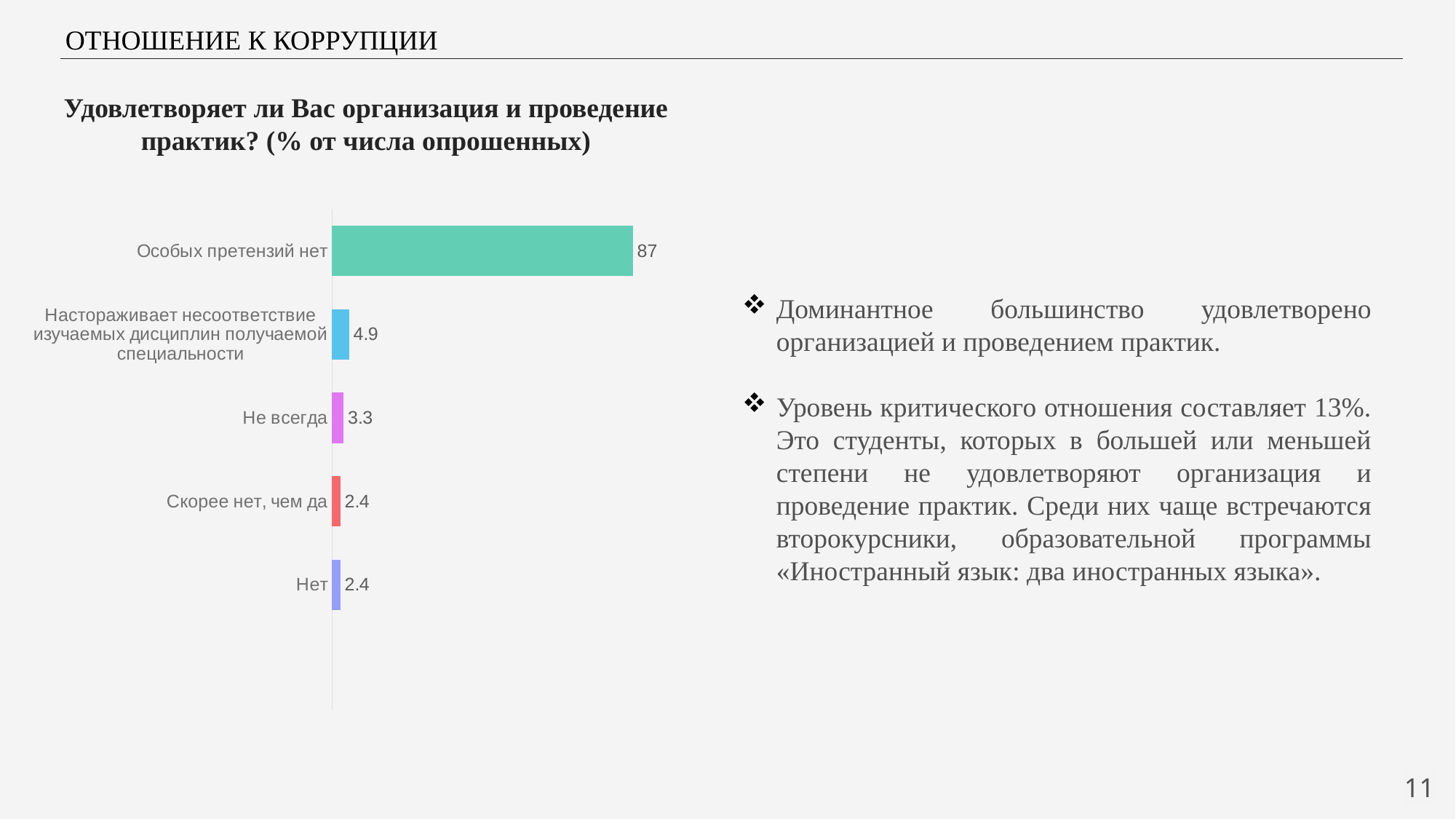
What is the value for "Особых претензий нет"? 87 What is the value for "Настораживает несоответствие изучаемых дисциплин получаемой специальности"? 4.9 What is the difference between the values for "Не всегда" and "Нет"? 0.9 What is the value for "Скорее нет, чем да"? 2.4 Which category has the highest value? Особых претензий нет What kind of chart is shown on the slide? bar chart How many categories are shown in the chart? 5 What is the difference between the values for "Особых претензий нет" and "Настораживает несоответствие изучаемых дисциплин получаемой специальности"? 82.1 Which is larger, the value for "Не всегда" or the value for "Скорее нет, чем да"? Не всегда What colour is the bar for "Особых претензий нет"? green What is the title of the chart? Удовлетворяет ли Вас организация и проведение практик? (% от числа опрошенных) What is the value for "Не всегда"? 3.3